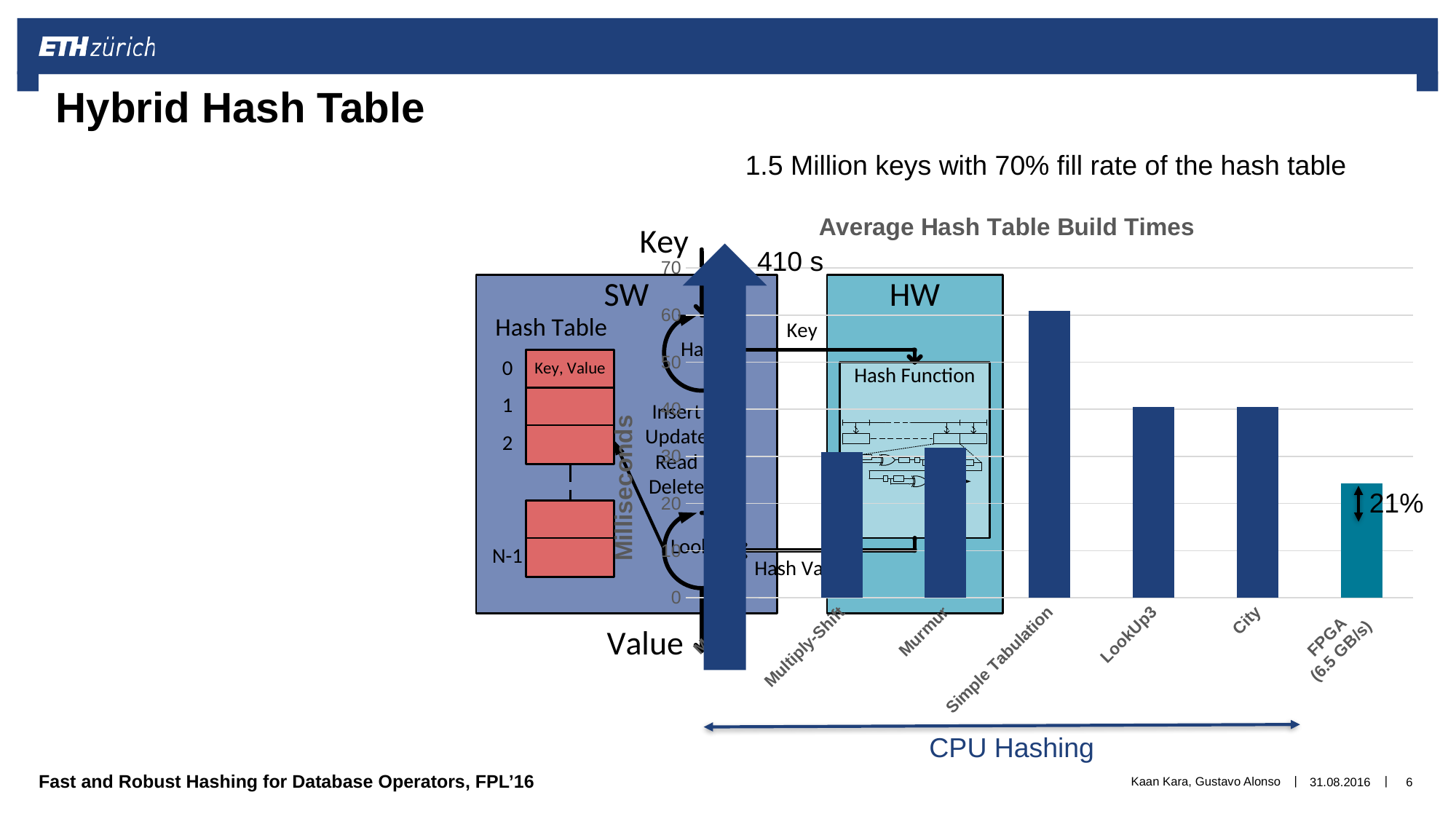
Is the value for Multiply-Shift greater or less than 20 milliseconds? greater What percentage annotation is shown next to the FPGA (6.5 GB/s) bar? 21% Which category has the lowest average hash table build time? FPGA (6.5 GB/s) What is the label of the y axis of the chart? Milliseconds Is the value for FPGA (6.5 GB/s) greater or less than 30 milliseconds? less Is the value for City greater or less than 30 milliseconds? greater Which has a higher average build time, Simple Tabulation or LookUp3? Simple Tabulation Which category has the highest average hash table build time? Simple Tabulation How many categories are shown on the x axis of the 'Average Hash Table Build Times' chart? 6 What kind of chart is 'Average Hash Table Build Times'? bar chart